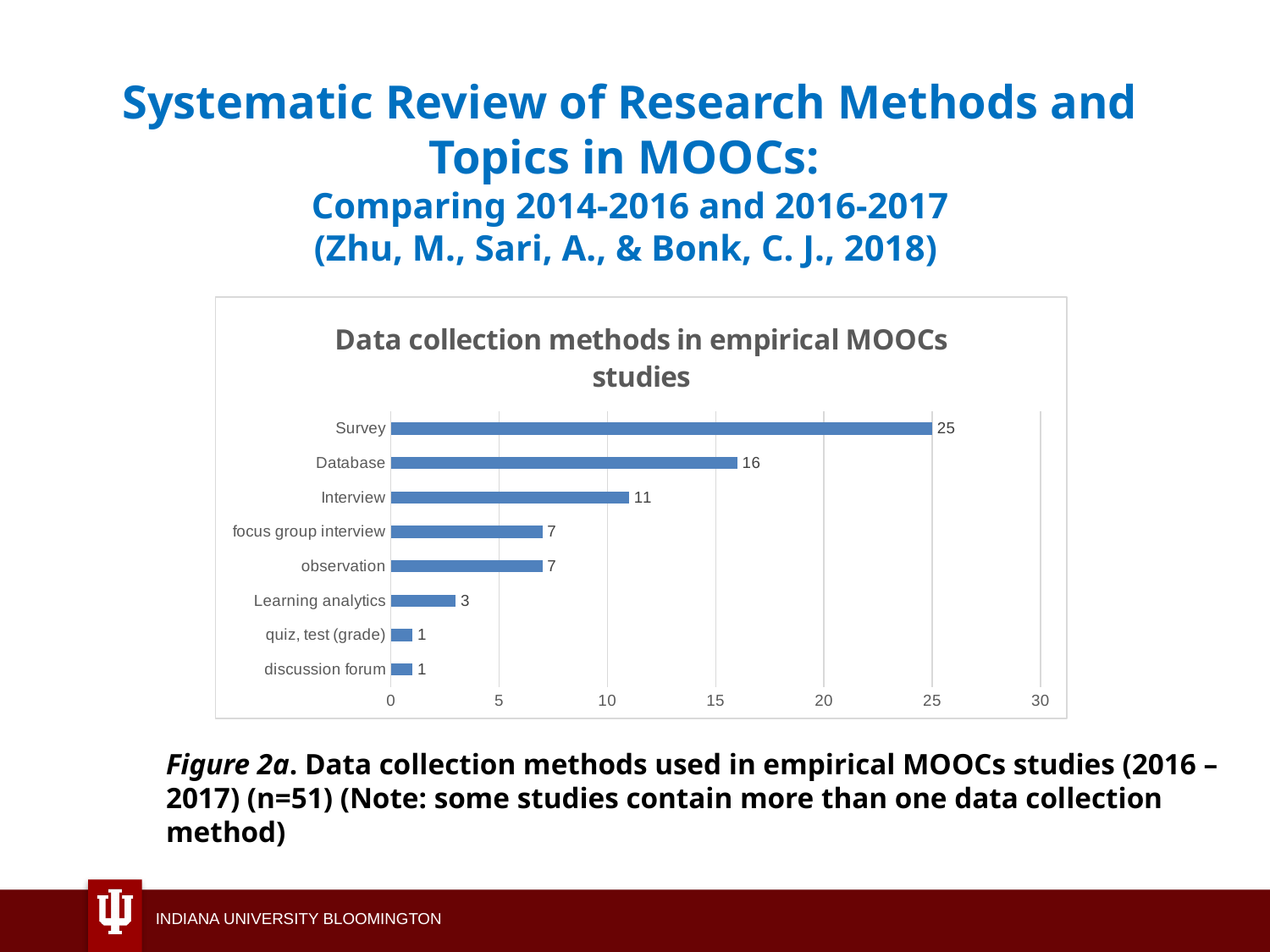
What kind of chart is shown on the slide? bar chart What is the value for Database? 16 What is the value for Learning analytics? 3 Which is larger, the value for Database or the value for Interview? Database What is the difference between the values for Database and Learning analytics? 13 Is the value for Interview greater or less than 10? greater What is the value for Survey? 25 How many data collection methods are shown in the chart? 8 Which data collection method has the highest value? Survey What is the value for observation? 7 What is the difference between the values for Survey and Interview? 14 What is the title of the chart? Data collection methods in empirical MOOCs studies